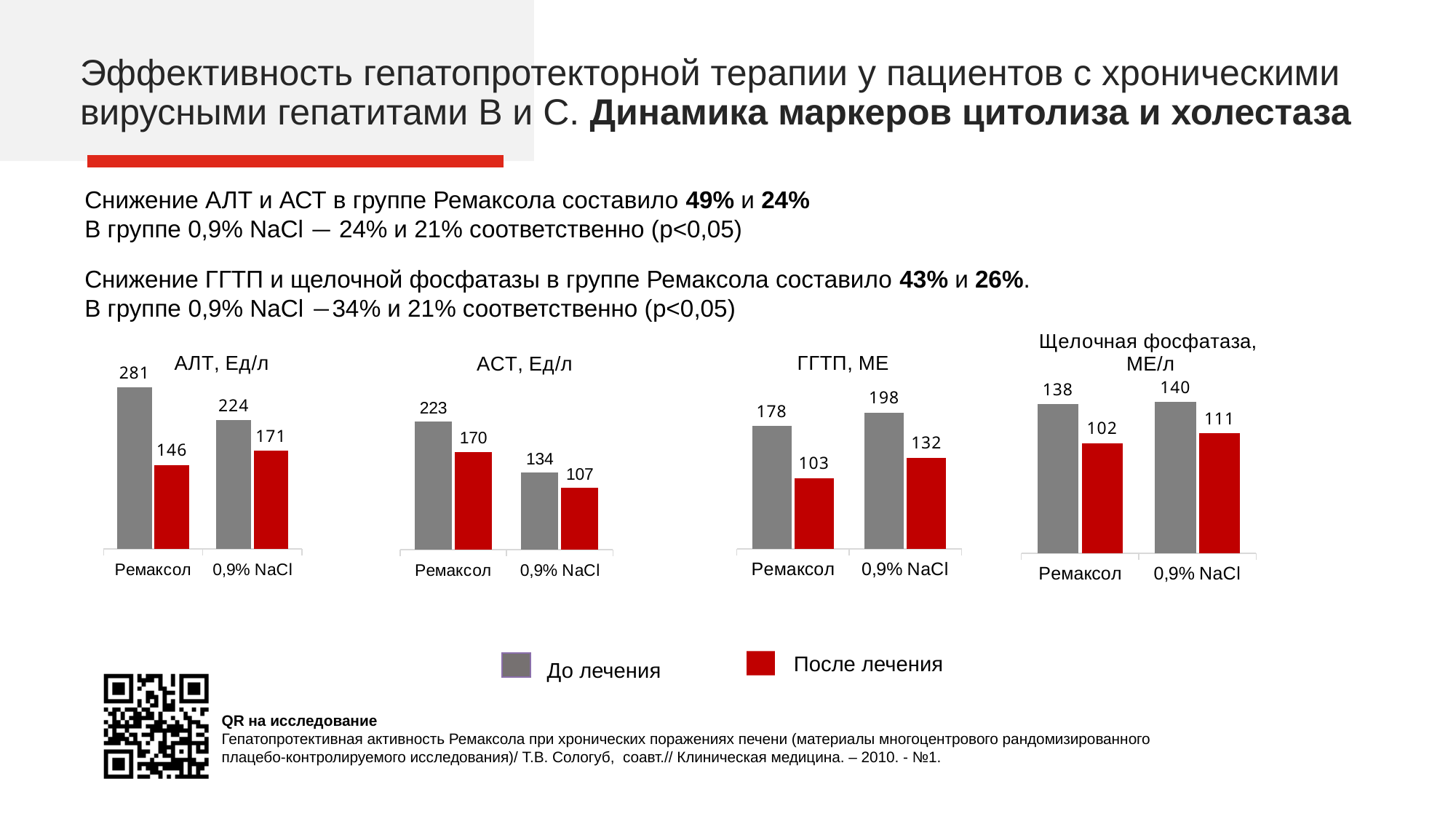
In the chart titled "ГГТП, МЕ", which bar is the lowest? Ремаксол, После лечения (103) In the chart titled "АСТ, Ед/л", what is the value for Ремаксол after treatment (После лечения)? 170 In the chart titled "АЛТ, Ед/л", what is the value for 0,9% NaCl after treatment (После лечения)? 171 In the chart titled "ГГТП, МЕ", what is the value for 0,9% NaCl before treatment (До лечения)? 198 In the chart titled "АЛТ, Ед/л", what is the difference between the Ремаксол values before and after treatment? 135 In the chart titled "Щелочная фосфатаза, МЕ/л", what is the difference between the 0,9% NaCl values before and after treatment? 29 In the chart titled "АЛТ, Ед/л", what is the value for Ремаксол before treatment (До лечения)? 281 Which colour represents "После лечения" in the legend? Red What type of chart is the "АСТ, Ед/л" chart? Bar chart In the chart titled "Щелочная фосфатаза, МЕ/л", what is the value for Ремаксол after treatment (После лечения)? 102 How many series does the shared legend list for the charts? 2 In the chart titled "АСТ, Ед/л", which is larger: the 0,9% NaCl value before treatment or the Ремаксол value after treatment? Ремаксол after treatment (170)